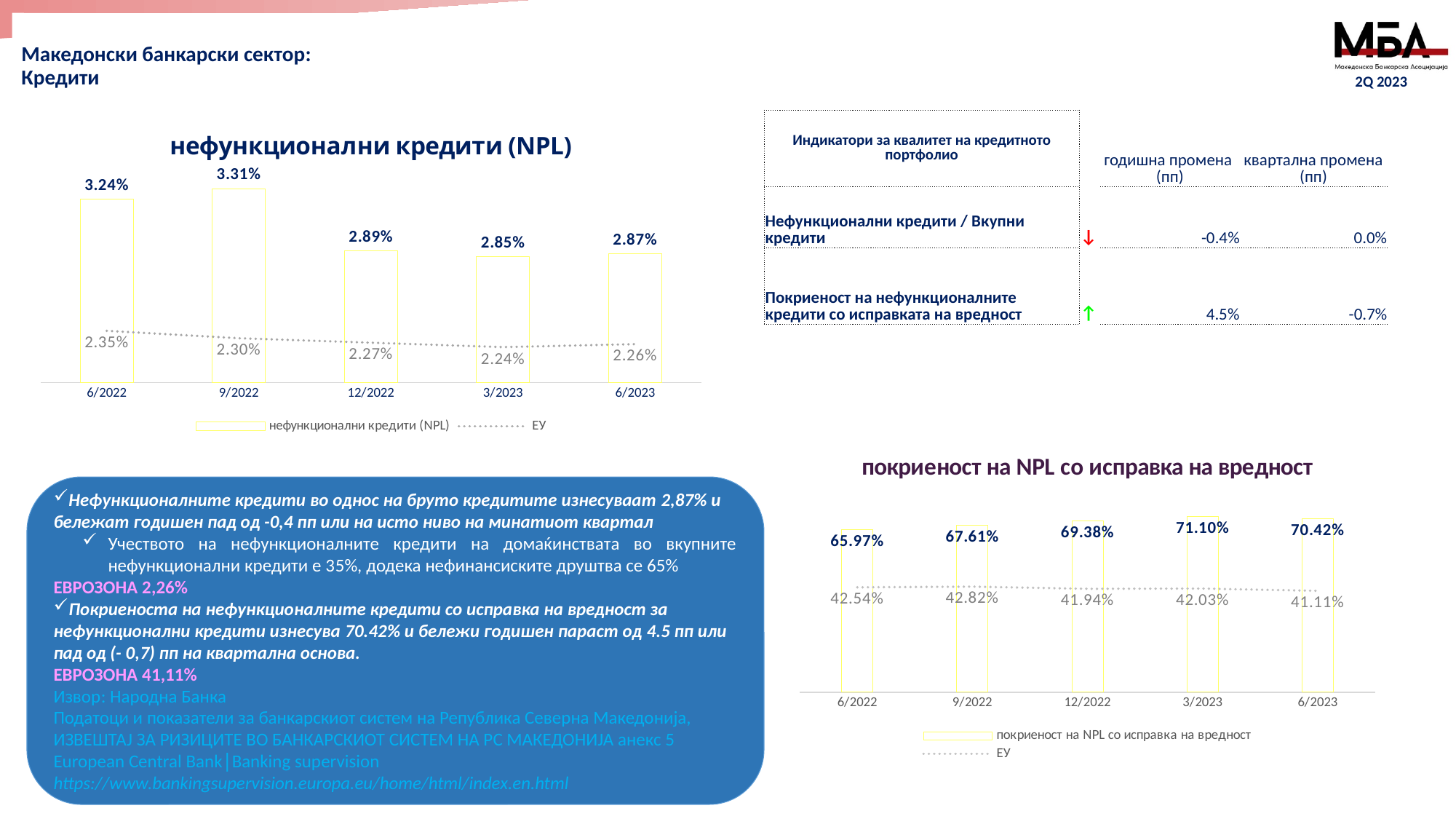
What kind of chart is the chart titled "покриеност на NPL со исправка на вредност"? Bar chart with a line In the chart titled "нефункционални кредити (NPL)", how many series does the legend list? 2 In the chart titled "покриеност на NPL со исправка на вредност", is the coverage bar for 12/2022 larger or smaller than the bar for 9/2022? larger In the chart titled "покриеност на NPL со исправка на вредност", what is the coverage value for 3/2023? 71.10% In the chart titled "нефункционални кредити (NPL)", what is the NPL value for 6/2023? 2.87% In the chart titled "нефункционални кредити (NPL)", which period has the highest NPL bar? 9/2022 In the chart titled "покриеност на NPL со исправка на вредност", which period has the lowest coverage bar? 6/2022 In the chart titled "нефункционални кредити (NPL)", what is the difference between the NPL bar and the ЕУ value for 6/2022? 0.89% In the chart titled "покриеност на NPL со исправка на вредност", what is the ЕУ value for 6/2023? 41.11% In the chart titled "нефункционални кредити (NPL)", what is the ЕУ value for 3/2023? 2.24% In the chart titled "покриеност на NPL со исправка на вредност", what is the difference between the coverage bar and the ЕУ value for 6/2023? 29.31% In the chart titled "нефункционални кредити (NPL)", how many periods are shown on the x axis? 5